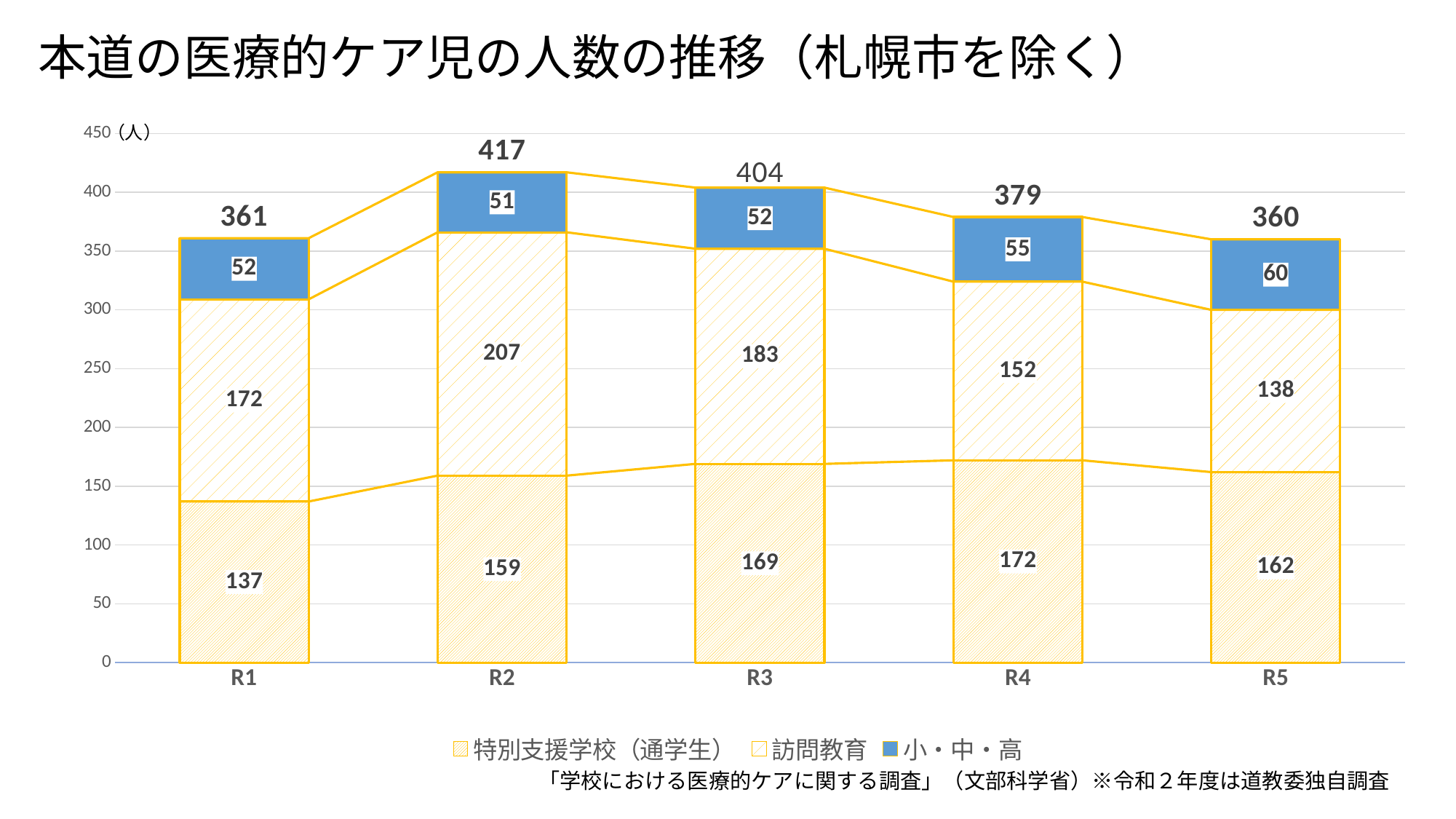
Which year has the highest total? R2 Which year has the lowest value for 訪問教育? R5 What is the title of the chart? 本道の医療的ケア児の人数の推移（札幌市を除く） What is the value for 小・中・高 in R5? 60 How many categories are shown on the x axis? 5 What is the value for 訪問教育 in R2? 207 Which is larger in R1: 特別支援学校（通学生） or 訪問教育? 訪問教育 What is the total of the stacked bar for R3? 404 How many series does the legend list? 3 What type of chart is shown on the slide? stacked bar chart What is the difference between the totals for R2 and R5? 57 What is the value for 特別支援学校（通学生） in R4? 172